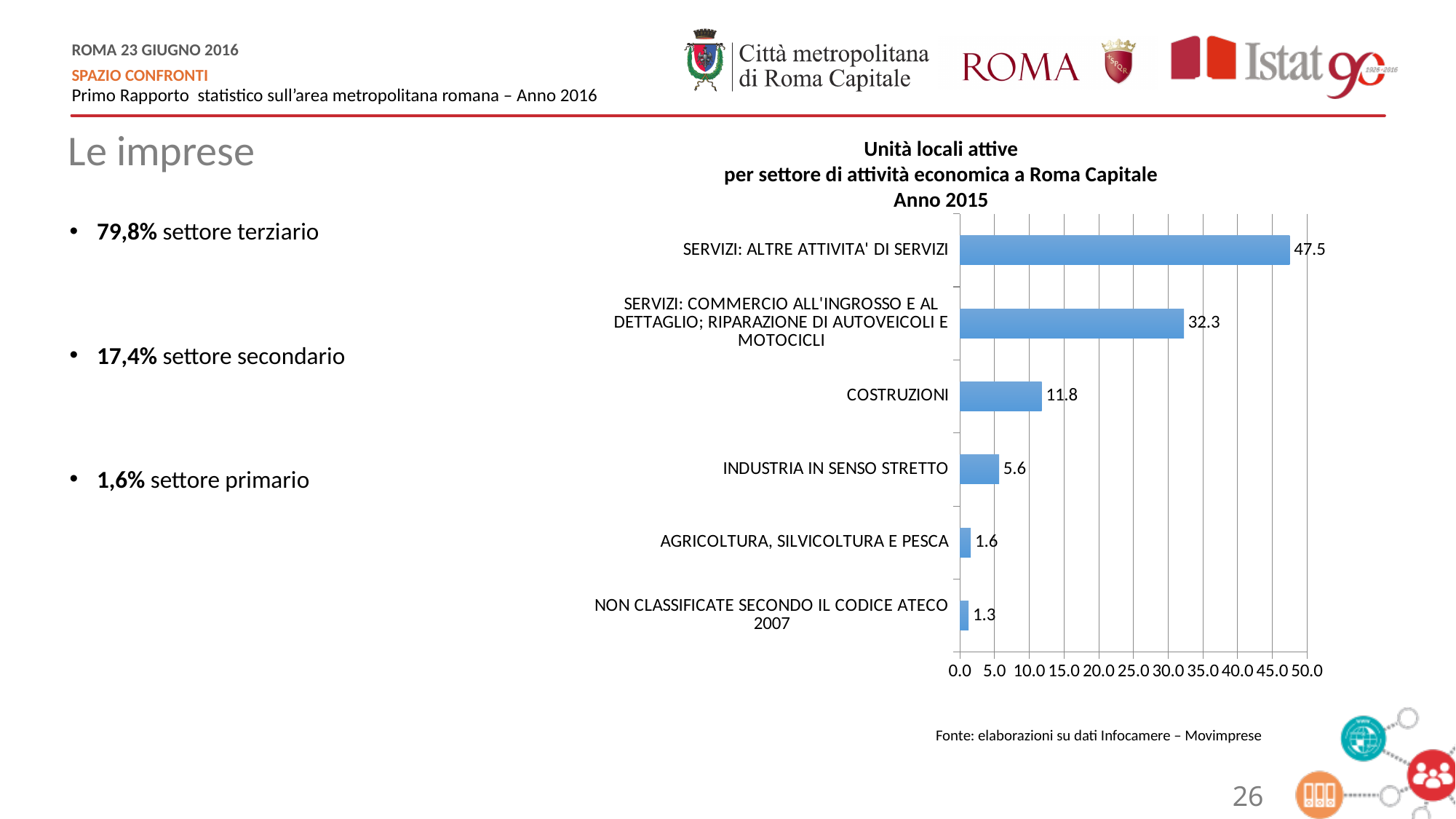
Which category has the highest value? SERVIZI: ALTRE ATTIVITA' DI SERVIZI What is the source cited below the chart? Fonte: elaborazioni su dati Infocamere – Movimprese What is the title of the chart? Unità locali attive per settore di attività economica a Roma Capitale Anno 2015 What is the value for INDUSTRIA IN SENSO STRETTO? 5.6 Which is larger, the value for COSTRUZIONI or the value for INDUSTRIA IN SENSO STRETTO? COSTRUZIONI What kind of chart is shown on the slide? bar chart What is the value for AGRICOLTURA, SILVICOLTURA E PESCA? 1.6 Is the value for SERVIZI: ALTRE ATTIVITA' DI SERVIZI greater or less than 45.0? greater What is the value for COSTRUZIONI? 11.8 Which category has the lowest value? NON CLASSIFICATE SECONDO IL CODICE ATECO 2007 What is the difference between the values for SERVIZI: ALTRE ATTIVITA' DI SERVIZI and SERVIZI: COMMERCIO ALL'INGROSSO E AL DETTAGLIO; RIPARAZIONE DI AUTOVEICOLI E MOTOCICLI? 15.2 How many categories are shown in the chart? 6